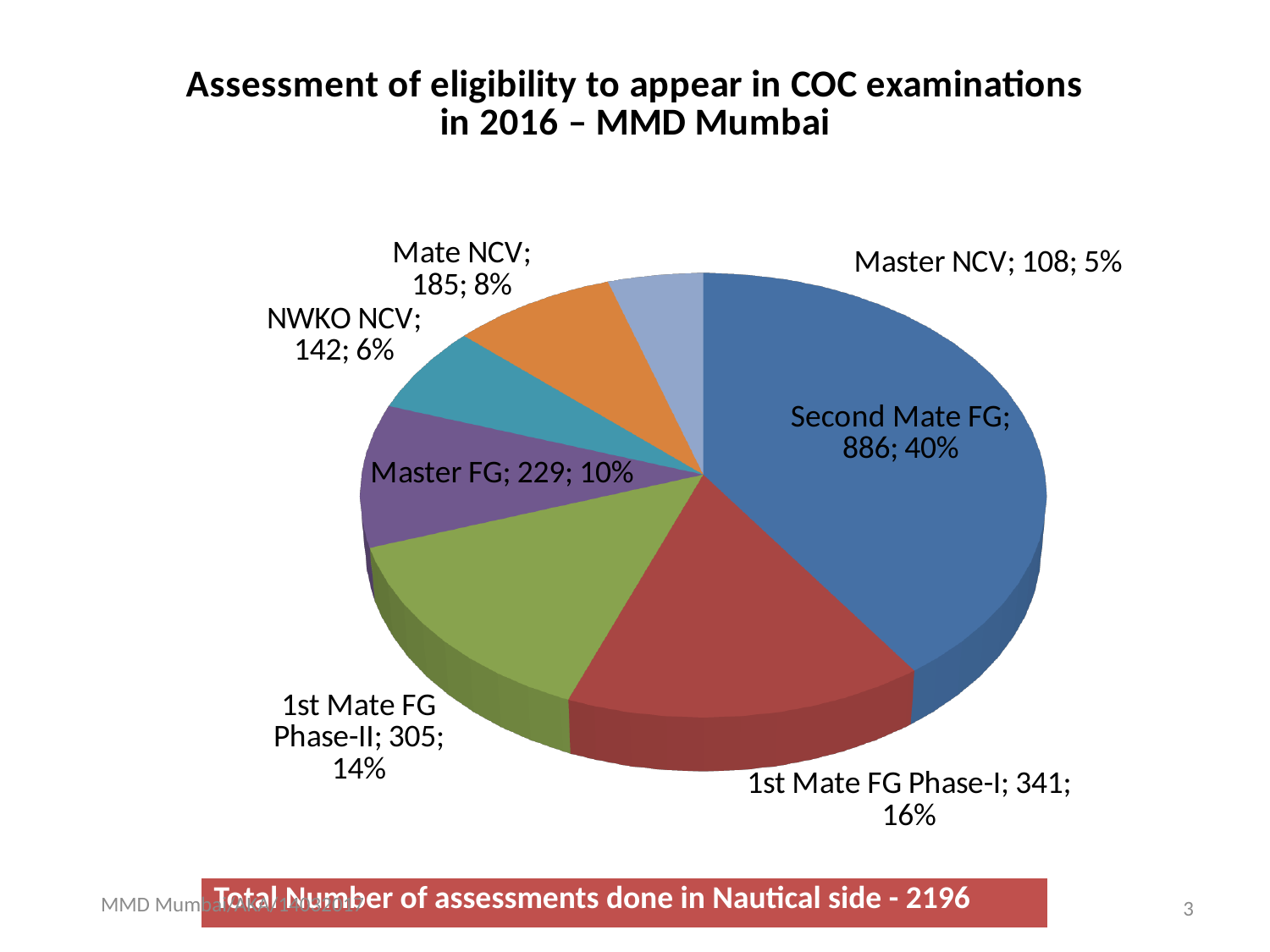
What is the difference between the values for 1st Mate FG Phase-I and 1st Mate FG Phase-II? 36 Which is larger, the value for NWKO NCV or the value for Mate NCV? Mate NCV Which category has the smallest slice? Master NCV What is the value for 1st Mate FG Phase-I? 341 What is the value for Second Mate FG? 886 What is the title of the chart? Assessment of eligibility to appear in COC examinations in 2016 – MMD Mumbai What type of chart is shown on the slide? Pie chart Which category has the largest slice? Second Mate FG How many categories (slices) does the pie chart have? 7 What percentage share does 1st Mate FG Phase-II have? 14% What percentage share does Mate NCV have? 8% What is the value for Master FG? 229